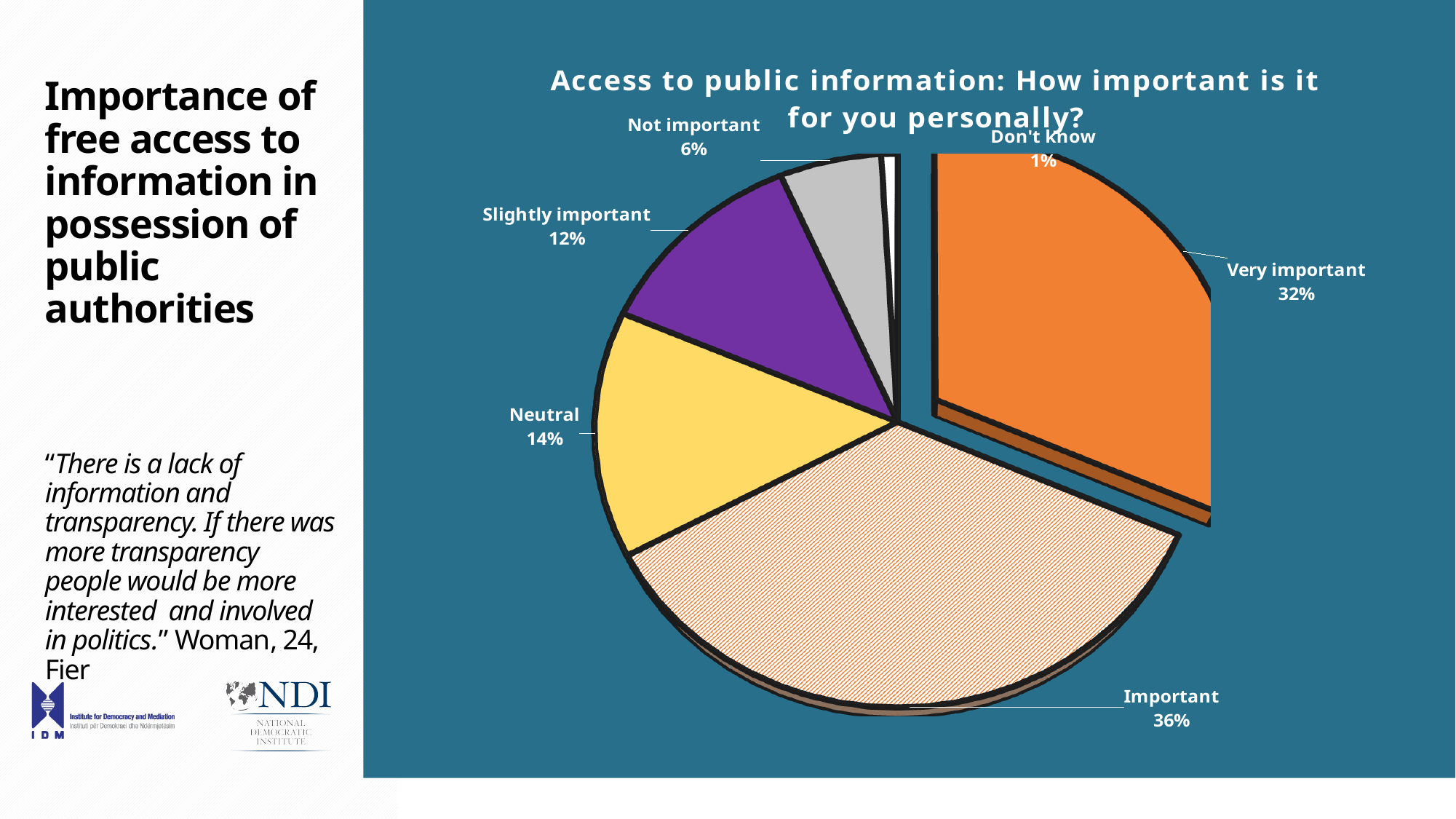
What is the combined share of Important and Very important? 68% What is the title of the chart? Access to public information: How important is it for you personally? What percentage is shown for Slightly important? 12% Which category has the largest slice of the pie? Important What type of chart is shown on the slide? Pie chart What share of the pie is labelled Neutral? 14% Which is larger, the share for Neutral or the share for Slightly important? Neutral What is the difference in percentage points between Important and Very important? 4 How many categories are shown in the pie chart? 6 What percentage of respondents said access to public information is very important for them personally? 32% Which category has the smallest slice of the pie? Don't know What percentage is shown for Not important? 6%